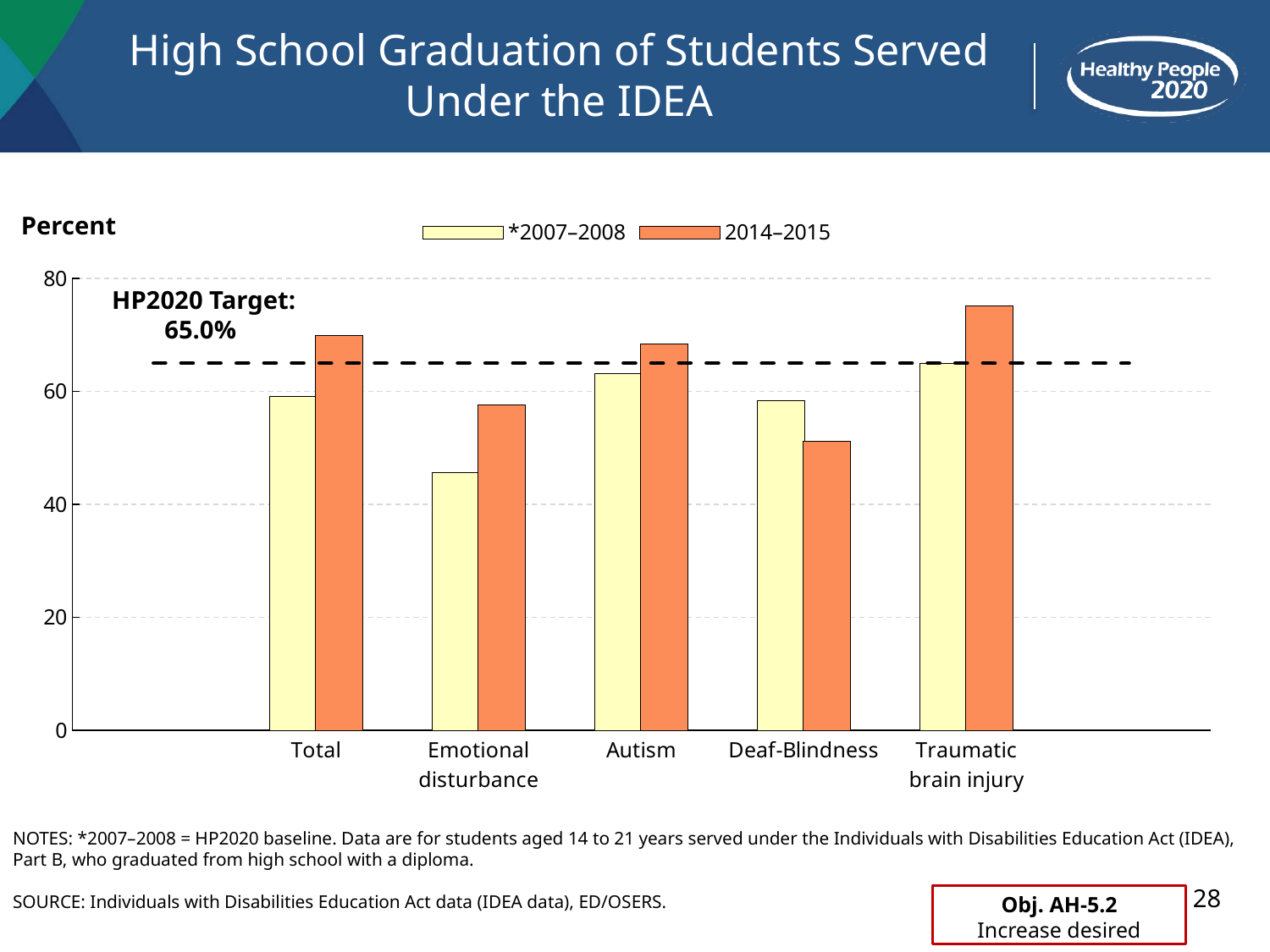
Is the *2007–2008 value for Emotional disturbance greater or less than 60? less Which category has the lowest value for 2014–2015? Deaf-Blindness Is the 2014–2015 value for Total greater or less than 60? greater What kind of chart is shown on the slide? bar chart For 2014–2015, which is larger: Emotional disturbance or Deaf-Blindness? Emotional disturbance Which category has the lowest value for *2007–2008? Emotional disturbance How many series does the legend list? 2 What is the HP2020 Target value shown on the chart? 65.0% Is the 2014–2015 value for Deaf-Blindness greater or less than 60? less How many categories are shown along the x axis? 5 For Deaf-Blindness, which is larger: the *2007–2008 value or the 2014–2015 value? *2007–2008 Which category has the highest value for 2014–2015? Traumatic brain injury